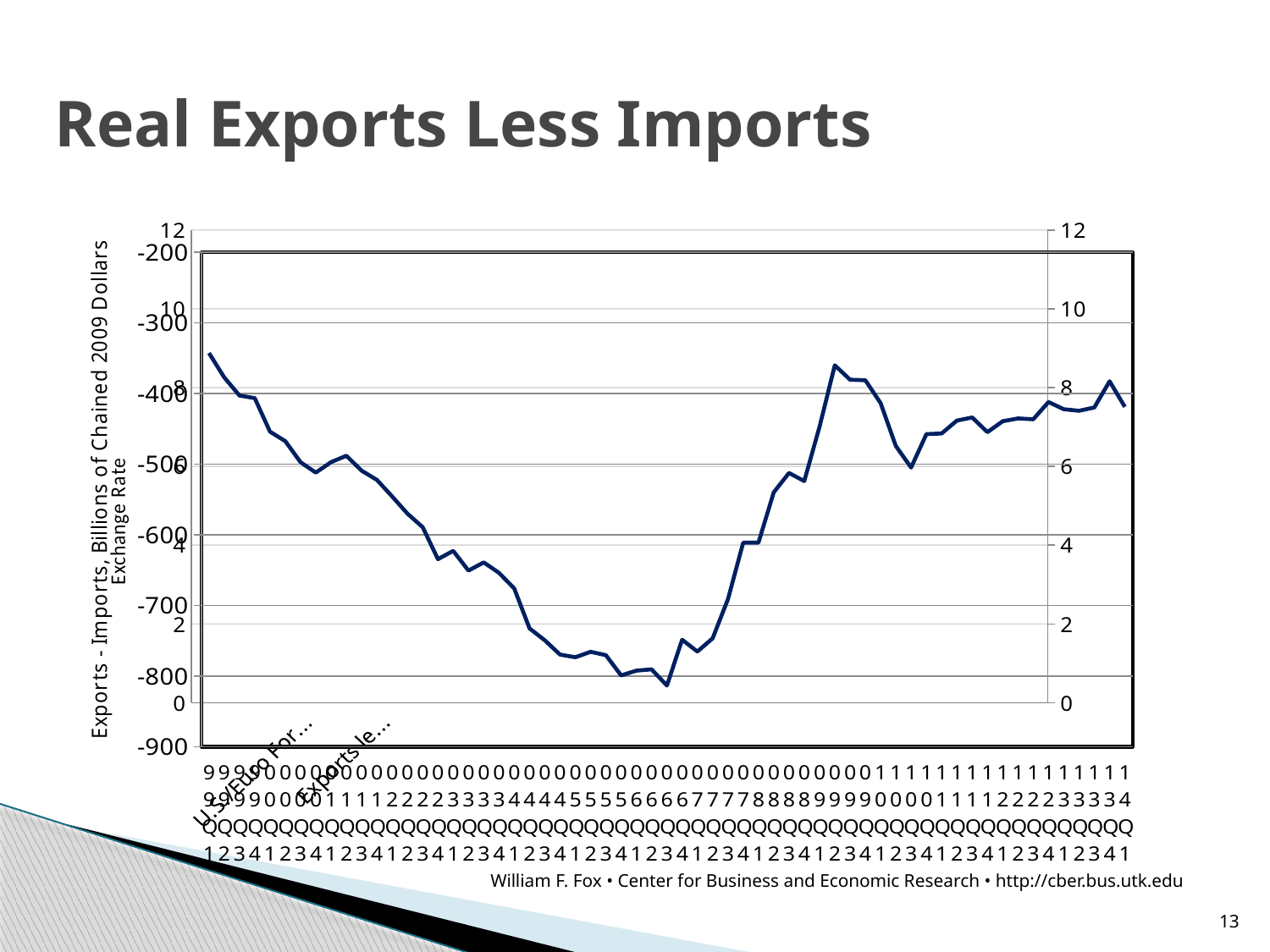
What is the lowest value shown on the left-hand Exports - Imports axis? -900 What is the title of the chart? Real Exports Less Imports Does the plotted line rise or fall between 2006 Q3 and 2009 Q2? rise How many series does the legend list? 2 What kind of chart is shown on the slide? line chart Is the value for 2006 Q3 greater or less than -700? less Which is larger, the value for 1999 Q1 or the value for 2006 Q3? 1999 Q1 Is the value for 1999 Q1 greater or less than -400? greater In which quarter does the plotted line reach its lowest point? 2006 Q3 Is the value for 2003 Q1 greater or less than -600? less Does the plotted line rise or fall between 1999 Q1 and 2006 Q3? fall